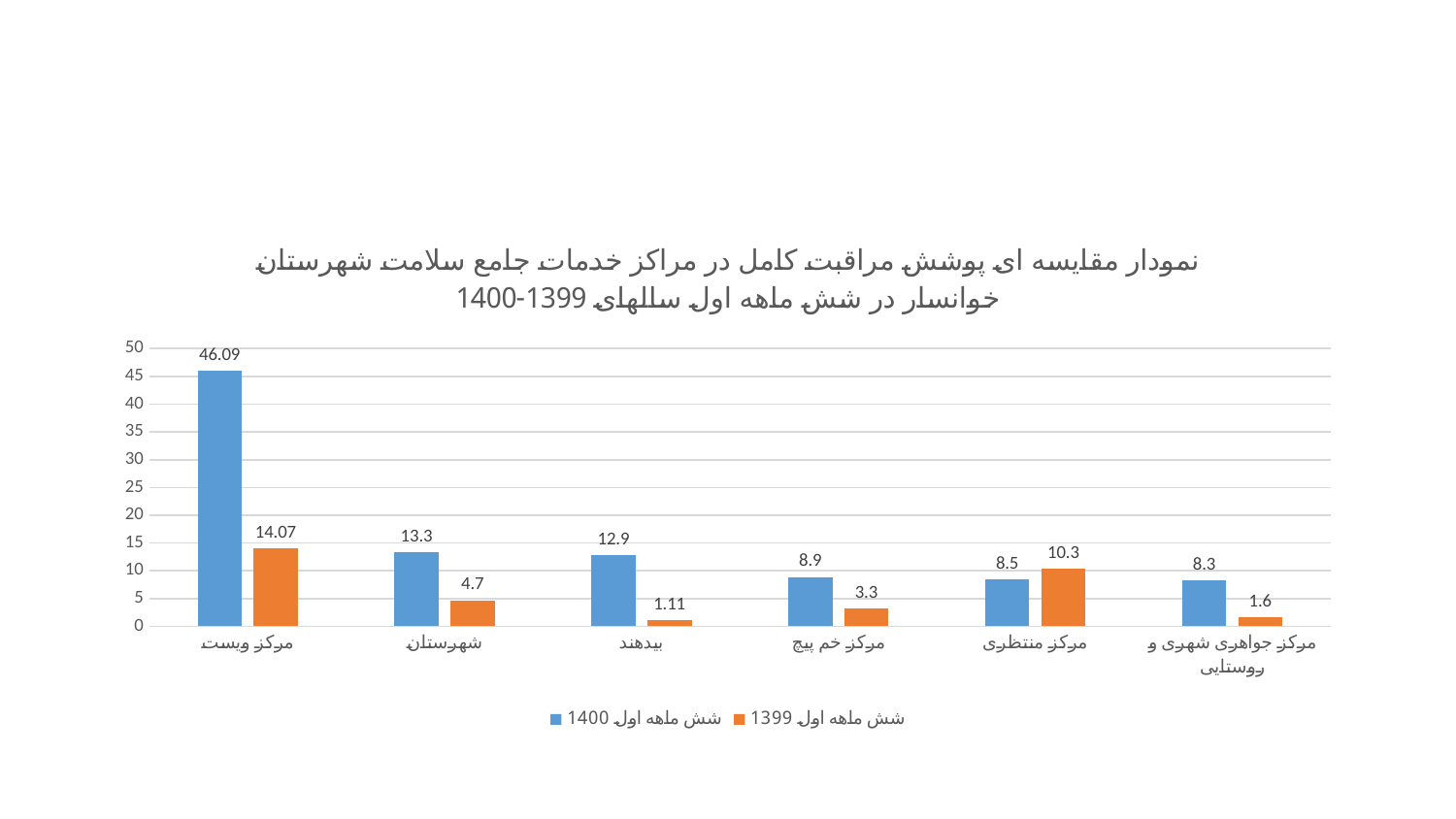
Is the value for شهرستان in the series شش ماهه اول 1400 greater or less than 10? greater What is the value for بیدهند in the series شش ماهه اول 1399? 1.11 Which colour represents the series شش ماهه اول 1399? orange What is the value for مرکز منتظری in the series شش ماهه اول 1399? 10.3 Which category has the highest value in the series شش ماهه اول 1400? مرکز ویست What kind of chart is shown on the slide? bar chart How many series does the legend list? 2 What is the value for مرکز ویست in the series شش ماهه اول 1400? 46.09 What is the difference between the شش ماهه اول 1400 and شش ماهه اول 1399 values for مرکز ویست? 32.02 Which category has the lowest value in the series شش ماهه اول 1399? بیدهند For مرکز منتظری, which series has the larger value: شش ماهه اول 1400 or شش ماهه اول 1399? شش ماهه اول 1399 How many categories are shown on the x axis? 6